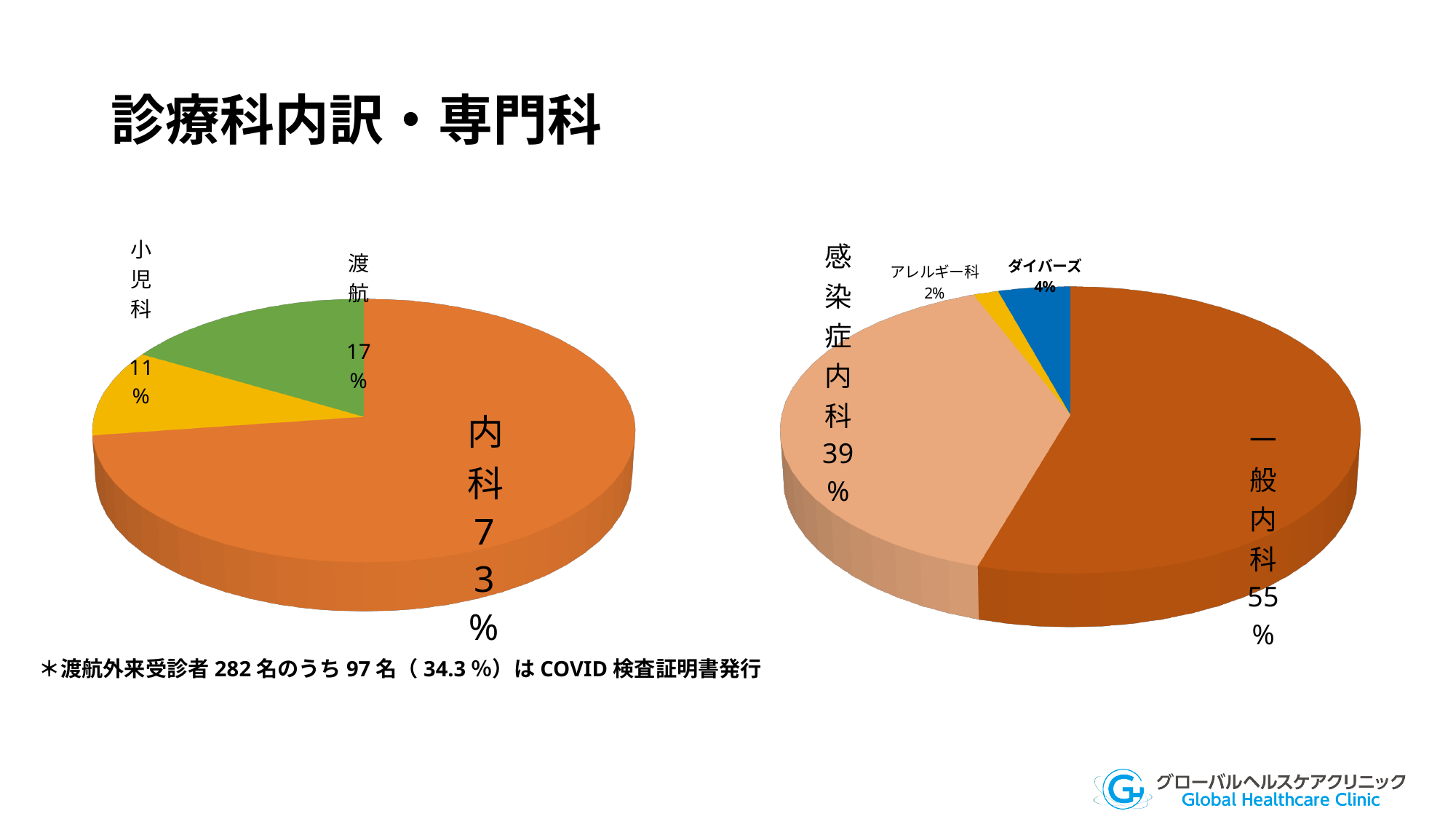
In the right pie chart, which category has the smallest slice? アレルギー科 In the left pie chart, what share does 渡航 have? 17% In the right pie chart, what share does 感染症内科 have? 39% In the left pie chart, what share does 内科 have? 73% In the right pie chart, what is the difference in percentage points between 一般内科 and 感染症内科? 16 In the left pie chart, which category has the smallest slice? 小児科 In the left pie chart, how many slices are there? 3 What kind of chart is shown on the right side of the slide? Pie chart In the left pie chart, which category has the largest slice? 内科